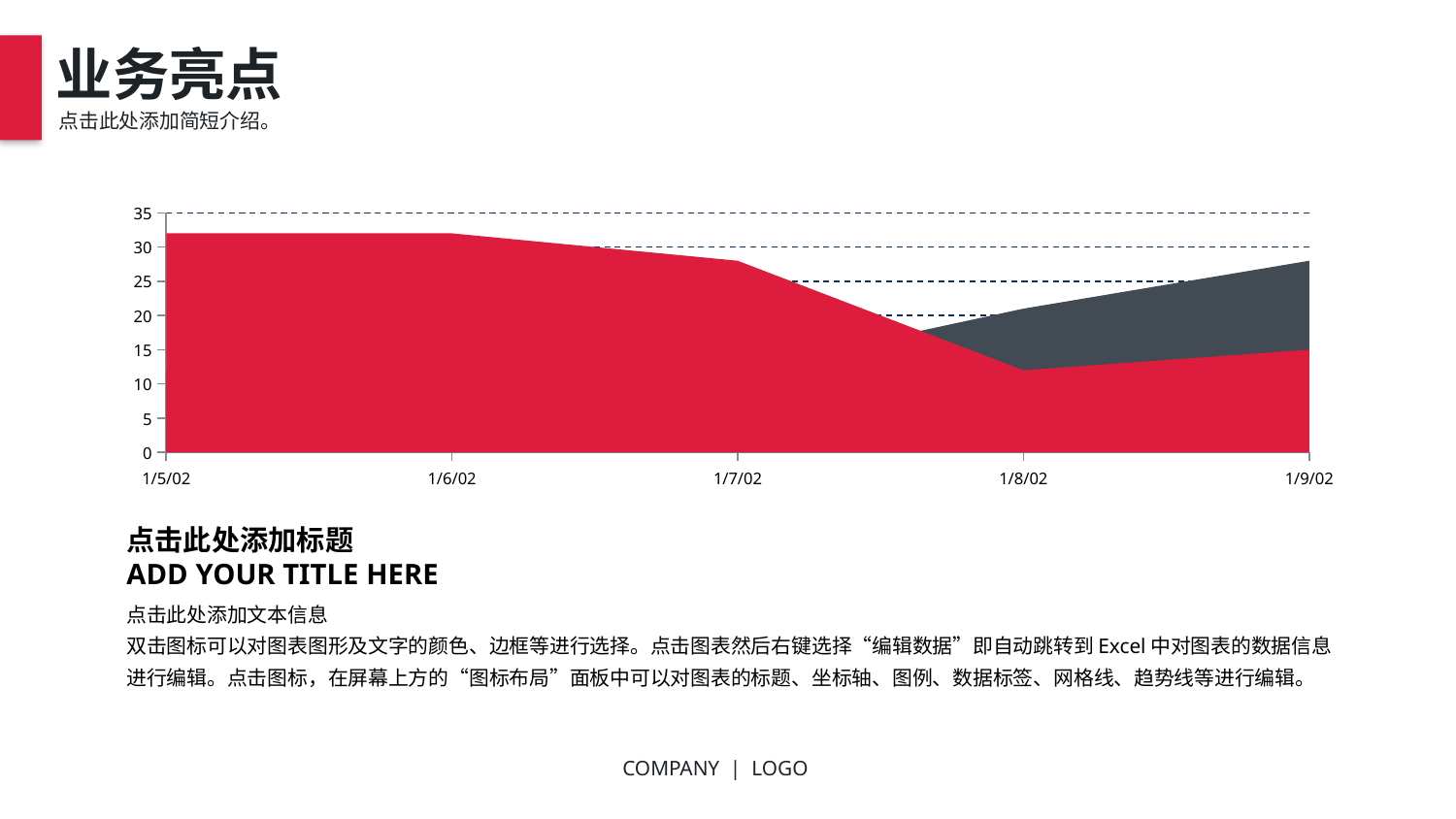
Is the value of the red series at 1/5/02 greater or less than 30? greater How many dates are shown on the x axis of the chart? 5 Does the dark gray series rise or fall from 1/8/02 to 1/9/02? rise Which is larger for the red series, the value at 1/7/02 or the value at 1/8/02? 1/7/02 Is the value of the dark gray series at 1/9/02 greater or less than 25? greater What kind of chart is shown on the slide? area chart Is the value of the red series at 1/8/02 greater or less than 15? less What is the highest value shown on the y axis of the chart? 35 Does the red series rise or fall from 1/5/02 to 1/8/02? fall At which date does the red series reach its lowest value? 1/8/02 What is the first date label on the x axis of the chart? 1/5/02